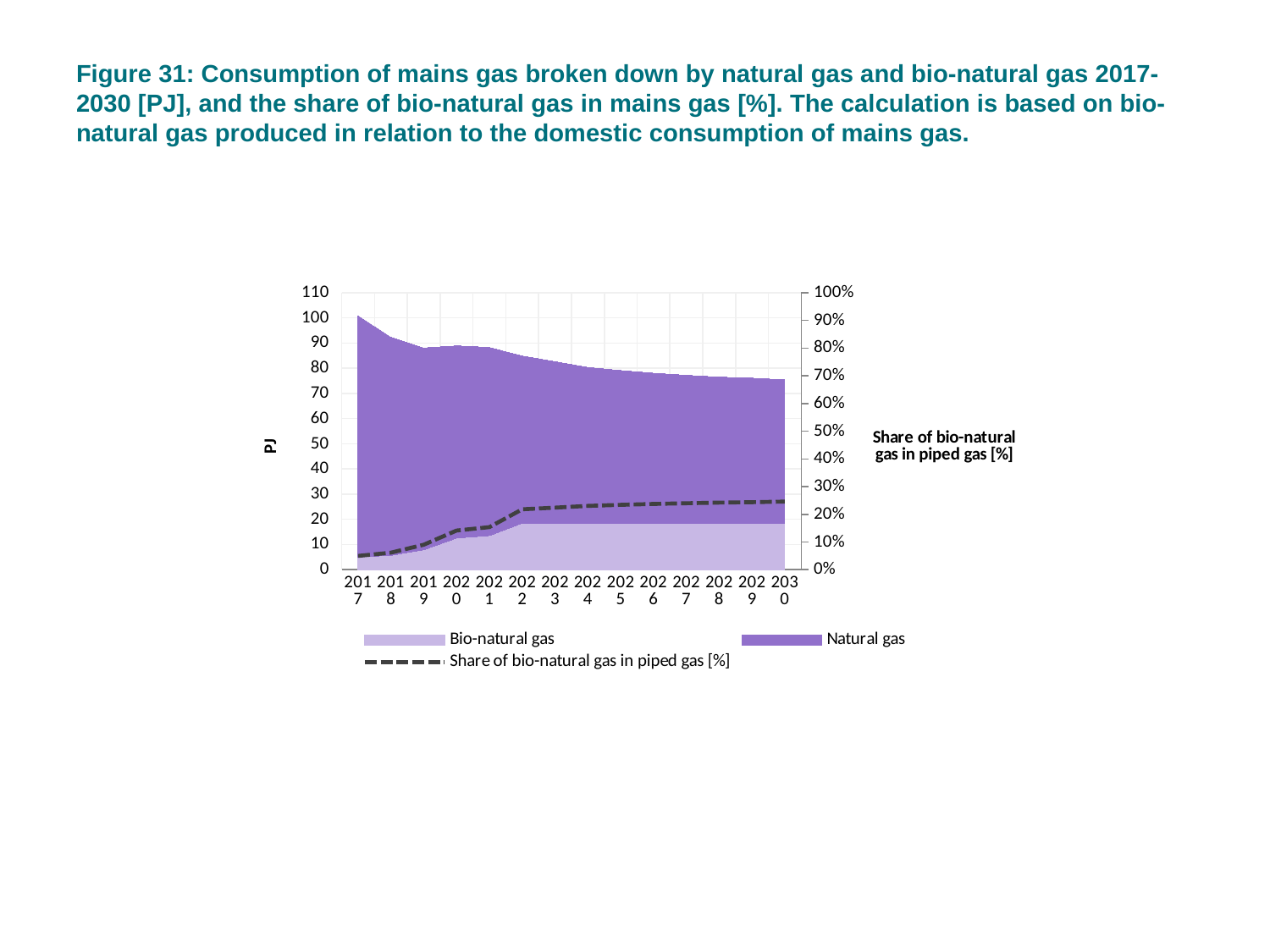
How many series does the legend list? 3 Is the bio-natural gas consumption in 2030 greater or less than 10 PJ? greater Is the total mains gas consumption in 2017 greater or less than 90 PJ? greater How many years are shown on the x axis? 14 Which series is plotted as a dashed line? Share of bio-natural gas in piped gas [%] Is the total mains gas consumption in 2030 greater or less than 80 PJ? less What is the label of the left vertical axis? PJ What kind of chart is shown on the slide? combination area and line chart In which year is the total mains gas consumption highest? 2017 Does the share of bio-natural gas in piped gas rise or fall from 2017 to 2030? rise Does the total mains gas consumption rise or fall from 2017 to 2030? fall